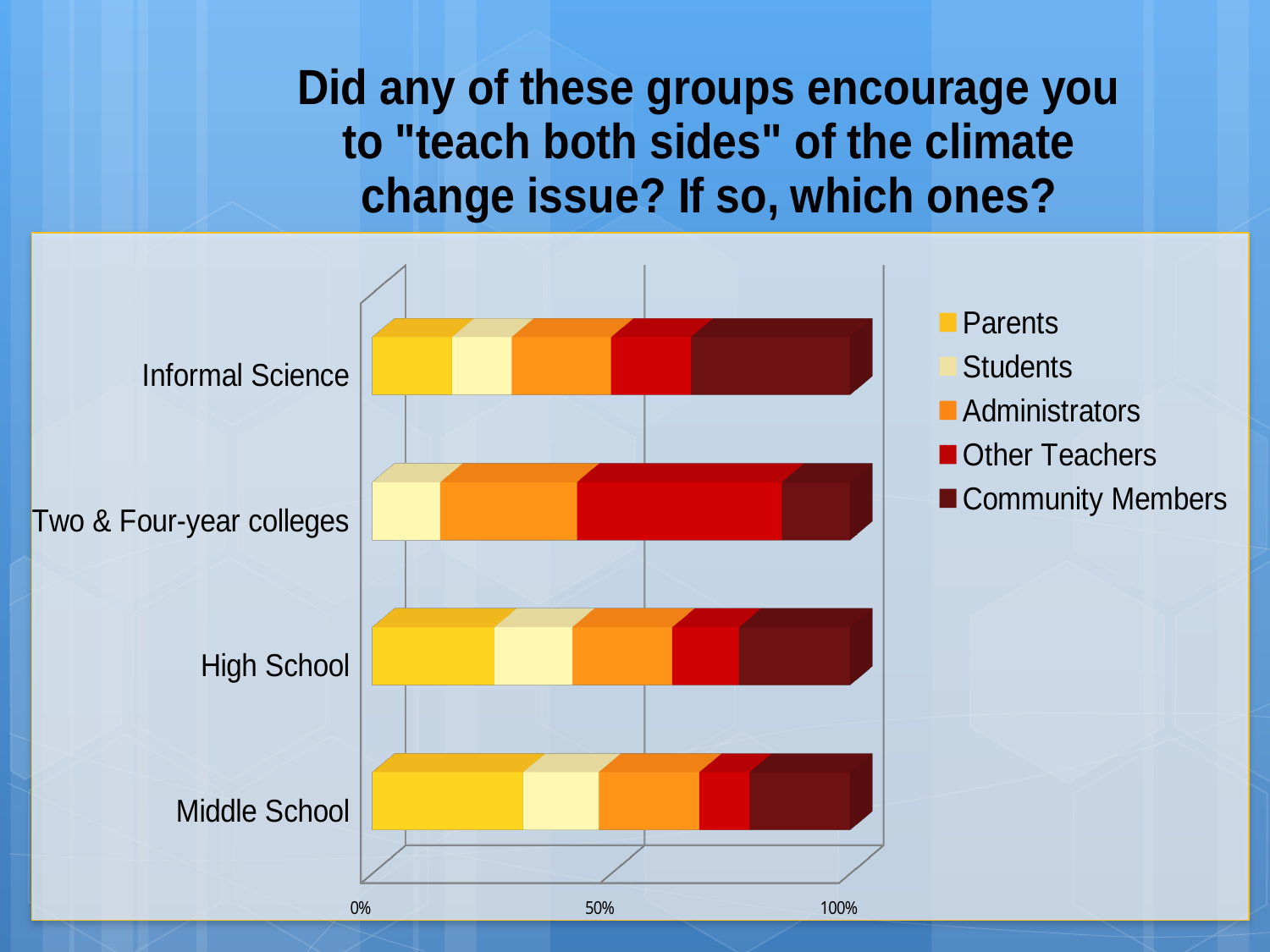
How many categories are shown on the vertical axis of the chart? 4 Is the Other Teachers share for Two & Four-year colleges larger or smaller than the Other Teachers share for Informal Science? larger Is the Parents share for Middle School greater or less than 50%? less What kind of chart is shown on the slide? stacked bar chart Which category's bar has no Parents segment? Two & Four-year colleges Is the Parents share for Middle School larger or smaller than the Parents share for Informal Science? larger Which series is listed first in the chart legend? Parents What is the highest value labelled on the horizontal axis? 100% Which series takes up the largest share of the Two & Four-year colleges bar? Other Teachers Which series takes up the smallest share of the Middle School bar? Other Teachers How many series does the chart legend list? 5 Which series is represented by the darkest red colour in the legend? Community Members